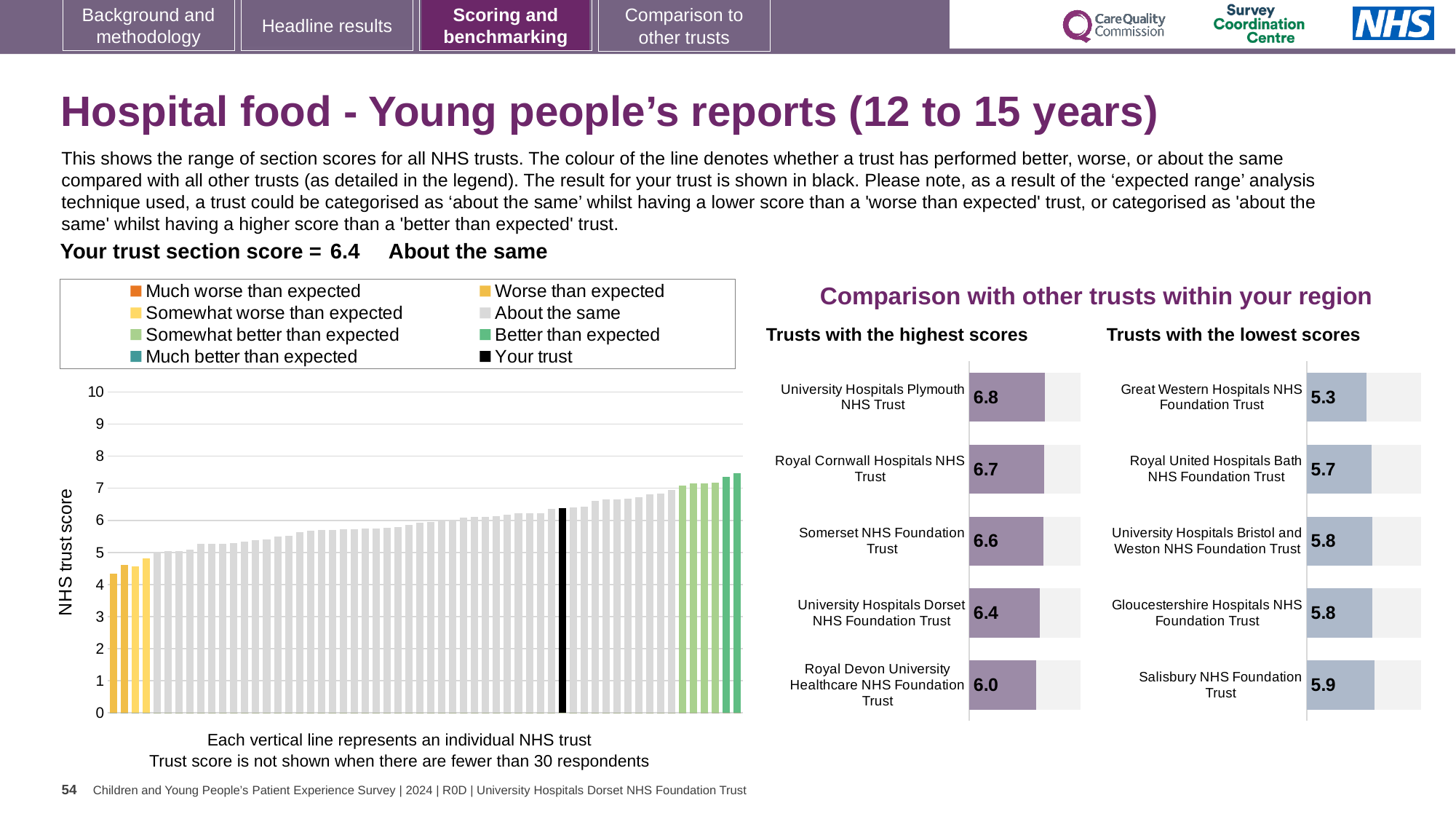
In the 'Trusts with the lowest scores' chart, how many trusts are shown? 5 In the large chart on the left showing NHS trust scores, what kind of chart is it? Bar chart In the large chart on the left showing NHS trust scores, how many entries does the legend list? 8 In the large chart on the left showing NHS trust scores, is the value of the black 'Your trust' bar greater or less than 6? greater In the 'Trusts with the highest scores' chart, what is the score for University Hospitals Plymouth NHS Trust? 6.8 In the 'Trusts with the highest scores' chart, which trust has the lowest score? Royal Devon University Healthcare NHS Foundation Trust In the 'Trusts with the lowest scores' chart, which trust has the highest score? Salisbury NHS Foundation Trust In the 'Trusts with the lowest scores' chart, which has the larger score: Royal United Hospitals Bath NHS Foundation Trust or Salisbury NHS Foundation Trust? Salisbury NHS Foundation Trust In the 'Trusts with the highest scores' chart, what is the difference between the scores of University Hospitals Plymouth NHS Trust and Royal Devon University Healthcare NHS Foundation Trust? 0.8 In the 'Trusts with the highest scores' chart, what is the score for Somerset NHS Foundation Trust? 6.6 In the 'Trusts with the lowest scores' chart, what is the score for Great Western Hospitals NHS Foundation Trust? 5.3 In the 'Trusts with the lowest scores' chart, what is the difference between the scores of Salisbury NHS Foundation Trust and Great Western Hospitals NHS Foundation Trust? 0.6